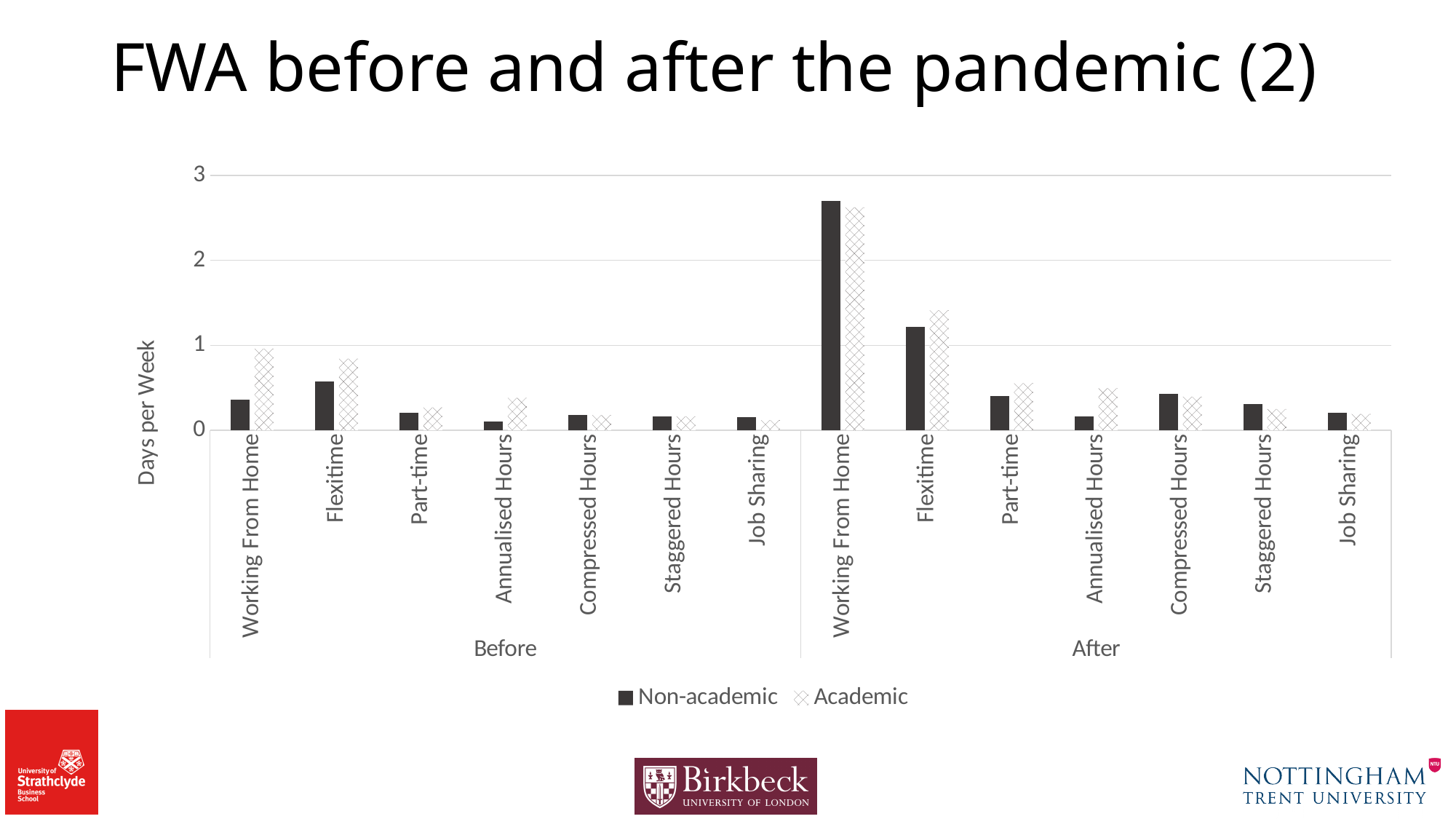
What kind of chart is shown on the slide? bar chart For Flexitime in the After group, which series has the larger value, Non-academic or Academic? Academic What are the two series named in the legend? Non-academic and Academic Is the Non-academic value for Working From Home in the After group greater or less than 2? greater For Annualised Hours in the After group, which series has the larger value, Non-academic or Academic? Academic How many flexible working arrangement categories are shown in the Before group? 7 What is the label on the vertical axis? Days per Week How many series does the legend list? 2 Is the Academic value for Flexitime in the After group greater or less than 1? greater Is the Non-academic value for Flexitime in the Before group greater or less than 1? less For Working From Home in the Before group, which series has the larger value, Non-academic or Academic? Academic Which category has the highest Non-academic value across the whole chart? Working From Home (After)